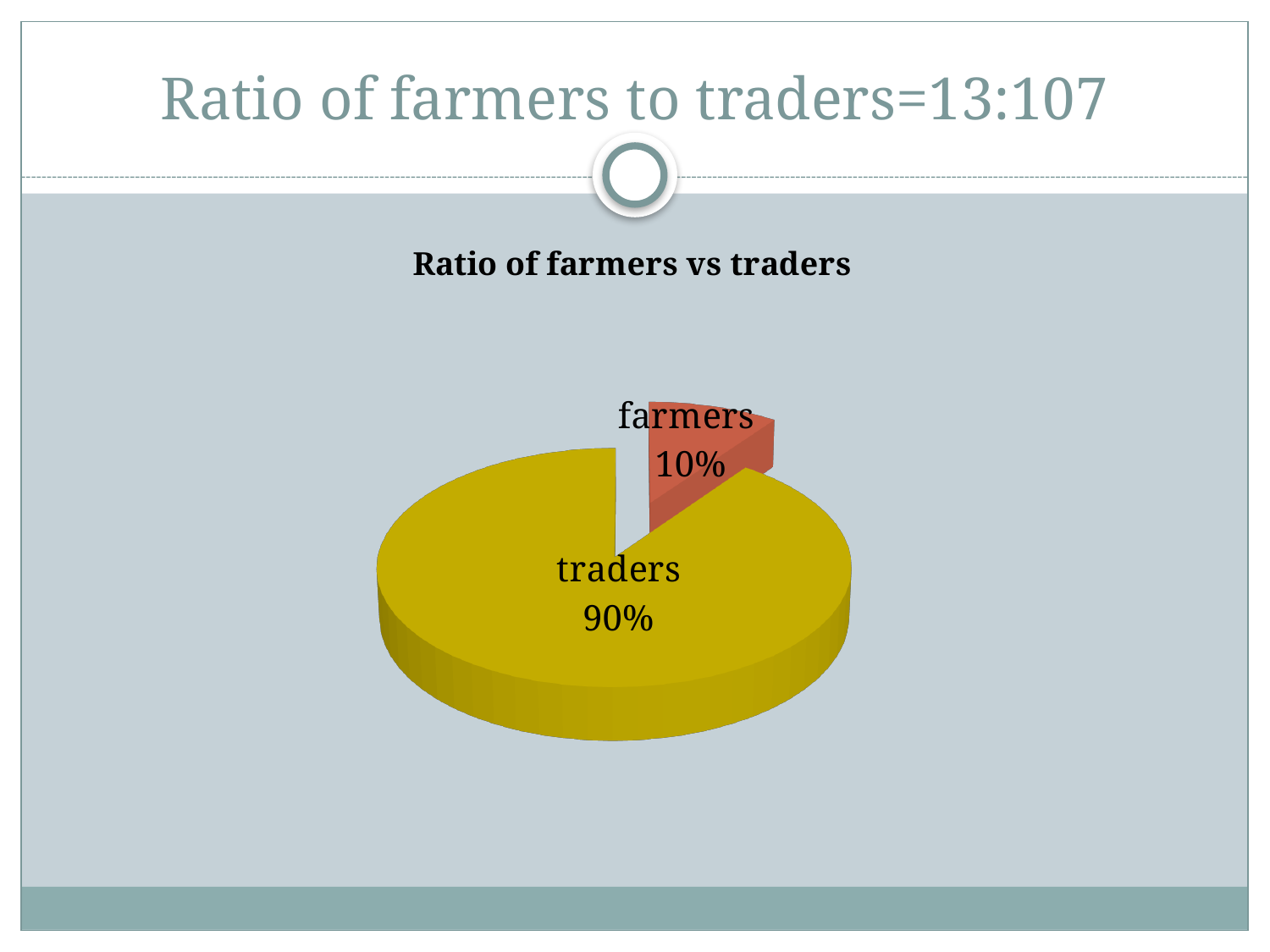
Which is larger, the farmers slice or the traders slice? traders Is the share for traders greater or less than 50%? greater What colour is the farmers slice? red What kind of chart is shown on the slide? pie chart How many slices does the pie chart have? 2 What is the title of the chart? Ratio of farmers vs traders Which slice is the largest? traders Which slice is the smallest? farmers What share of the pie do traders account for? 90% What share of the pie do farmers account for? 10% What is the difference in percentage points between the traders share and the farmers share? 80 percentage points